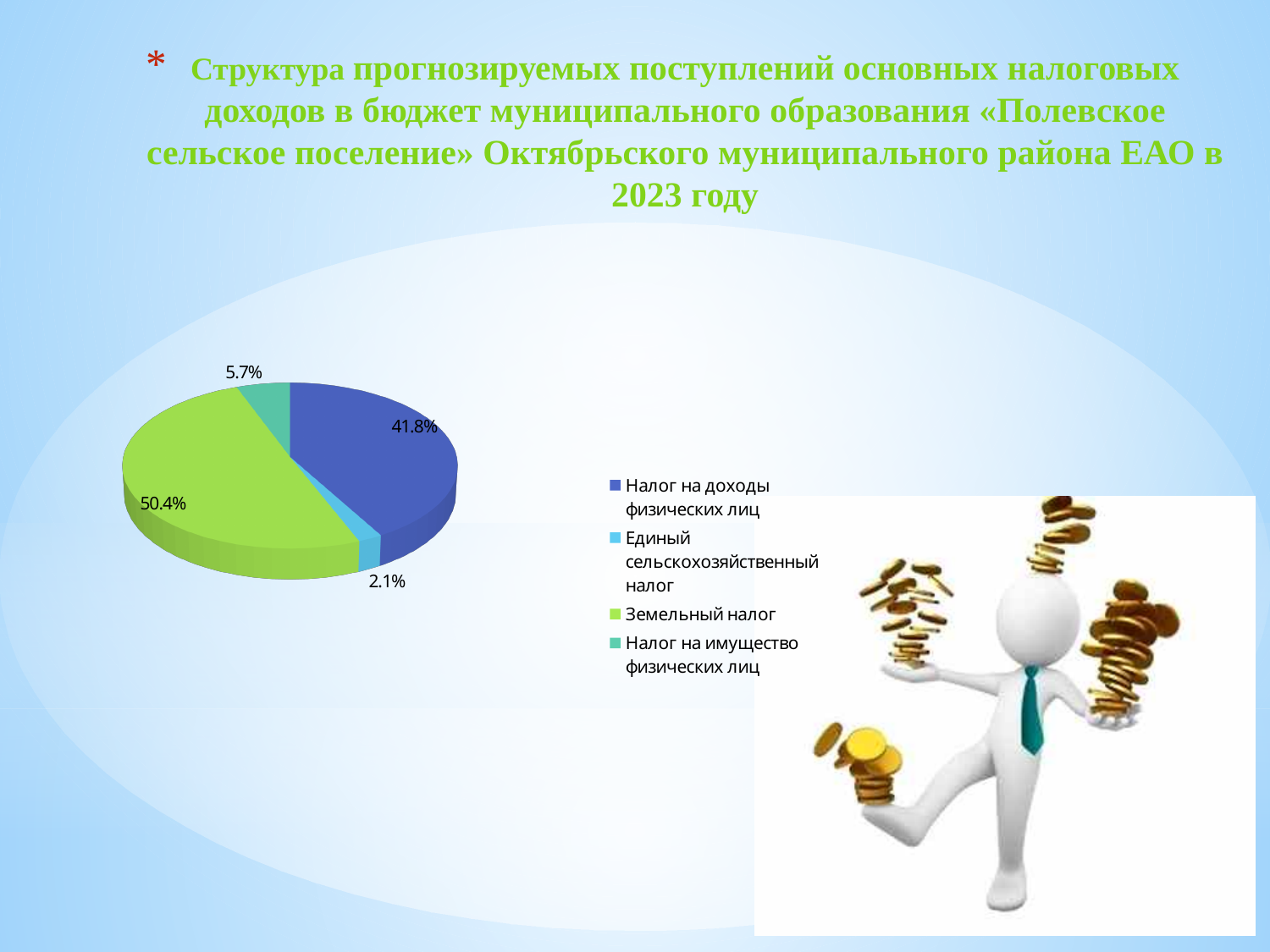
Which category has the smallest slice of the pie? Единый сельскохозяйственный налог What kind of chart is shown on the slide? Pie chart What colour is the slice for Земельный налог? Green How many categories does the pie chart show? 4 What share of the pie does Земельный налог have? 50.4% What share of the pie does Единый сельскохозяйственный налог have? 2.1% Which is larger: the share for Налог на имущество физических лиц or the share for Единый сельскохозяйственный налог? Налог на имущество физических лиц What share of the pie does Налог на имущество физических лиц have? 5.7% What is the difference in percentage points between Земельный налог and Налог на доходы физических лиц? 8.6 What is the difference in percentage points between Налог на имущество физических лиц and Единый сельскохозяйственный налог? 3.6 Which category has the largest slice of the pie? Земельный налог